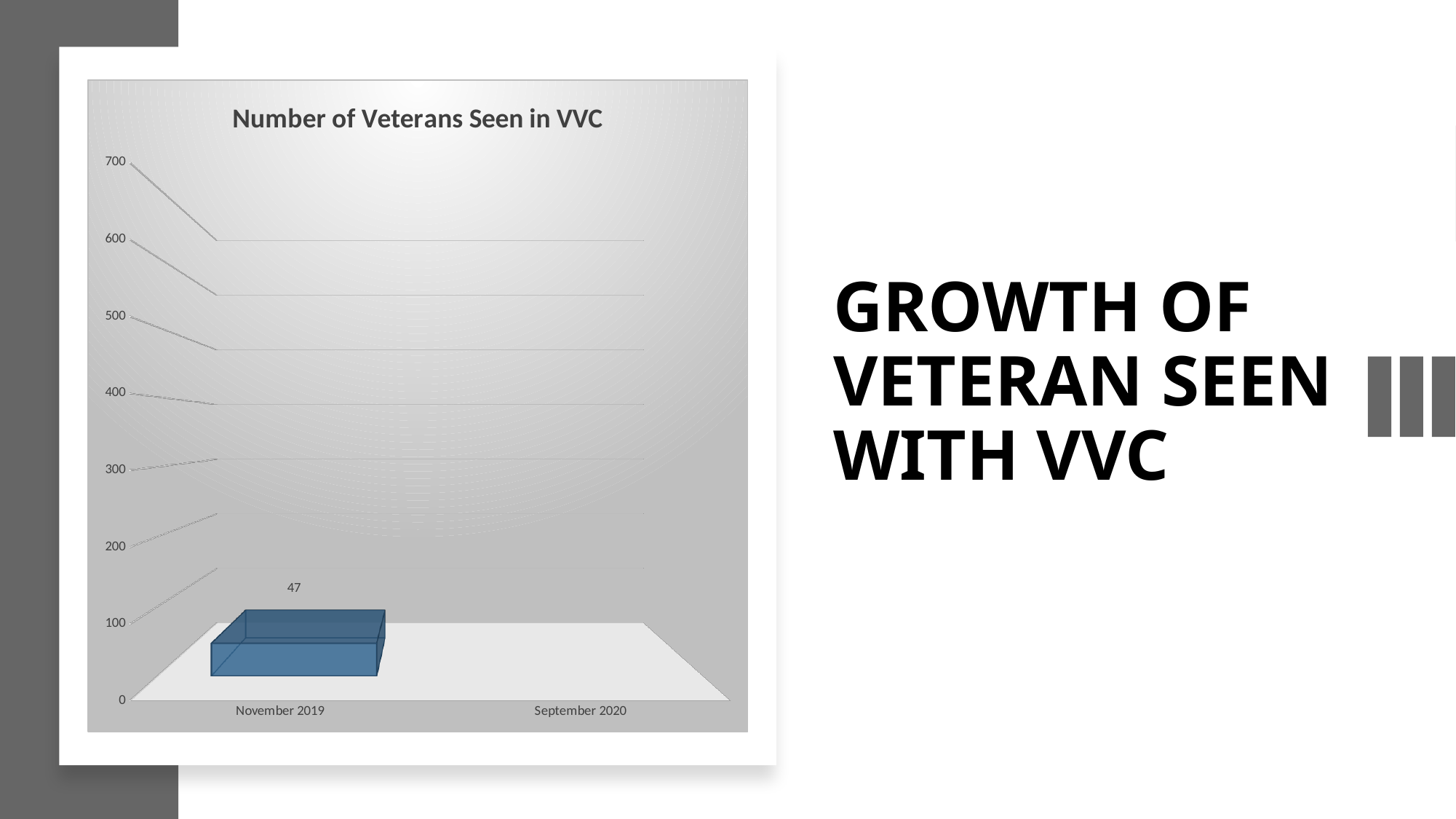
What is the number of veterans seen in VVC for November 2019? 47 What type of chart is shown on the slide? bar chart Is the value for November 2019 greater or less than 100? less How many categories are labelled on the x axis of the chart? 2 Which category on the x axis comes after November 2019? September 2020 What is the title of the chart? Number of Veterans Seen in VVC What is the highest value shown on the vertical axis of the chart? 700